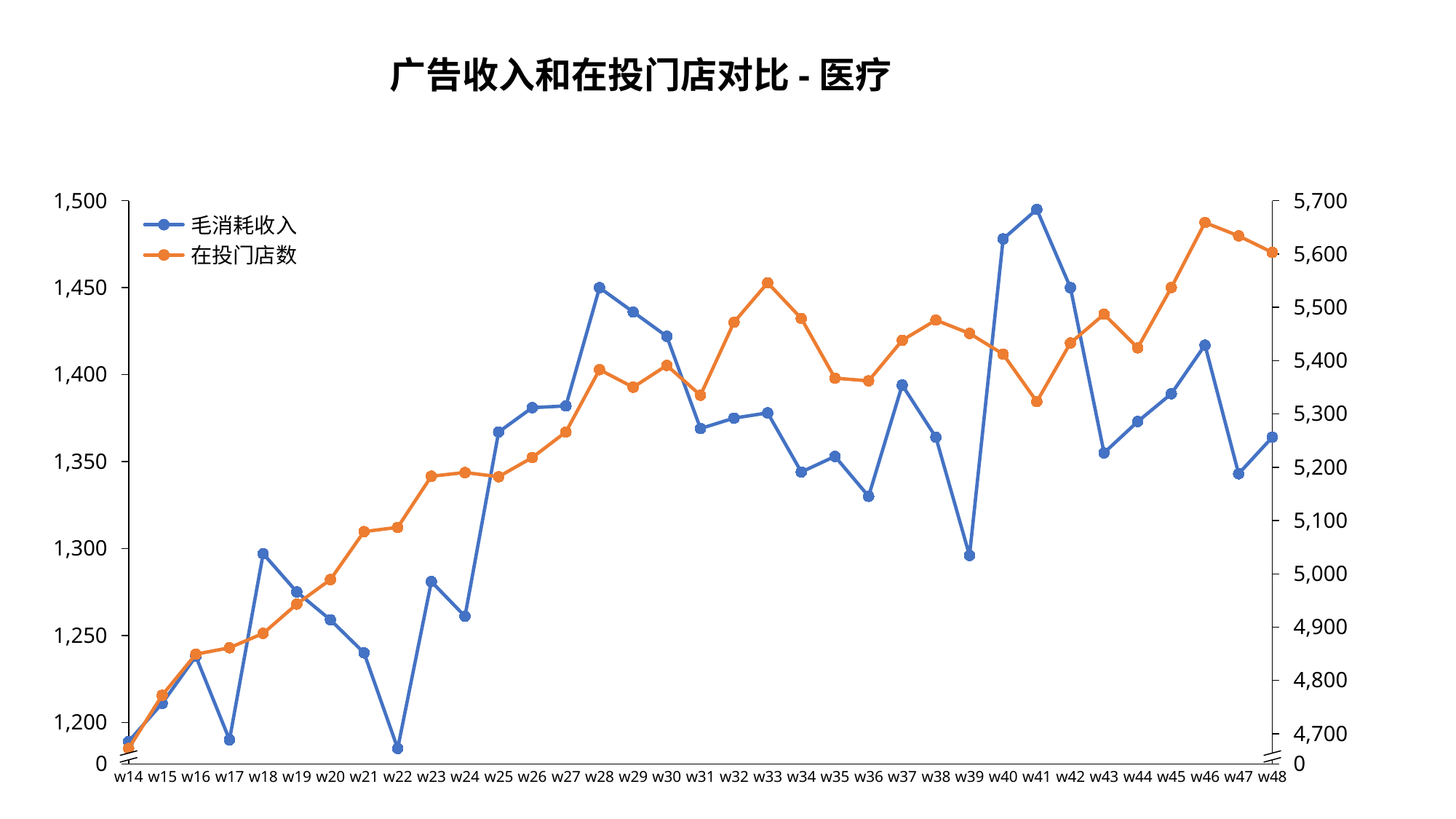
Is the value of 毛消耗收入 at w36 greater or less than 1,350? less In which week is 在投门店数 lowest? w14 Which week has the higher 毛消耗收入, w40 or w43? w40 What kind of chart is shown on the slide? line chart Is the value of 在投门店数 at w41 greater or less than 5,400? less In which week is 在投门店数 highest? w46 What is the title of the chart? 广告收入和在投门店对比 - 医疗 How many weeks are plotted along the x axis? 35 Does 在投门店数 generally rise or fall from w14 to w48? rise Is the value of 毛消耗收入 at w28 greater or less than 1,400? greater In which week is 毛消耗收入 highest? w41 How many series does the legend list? 2